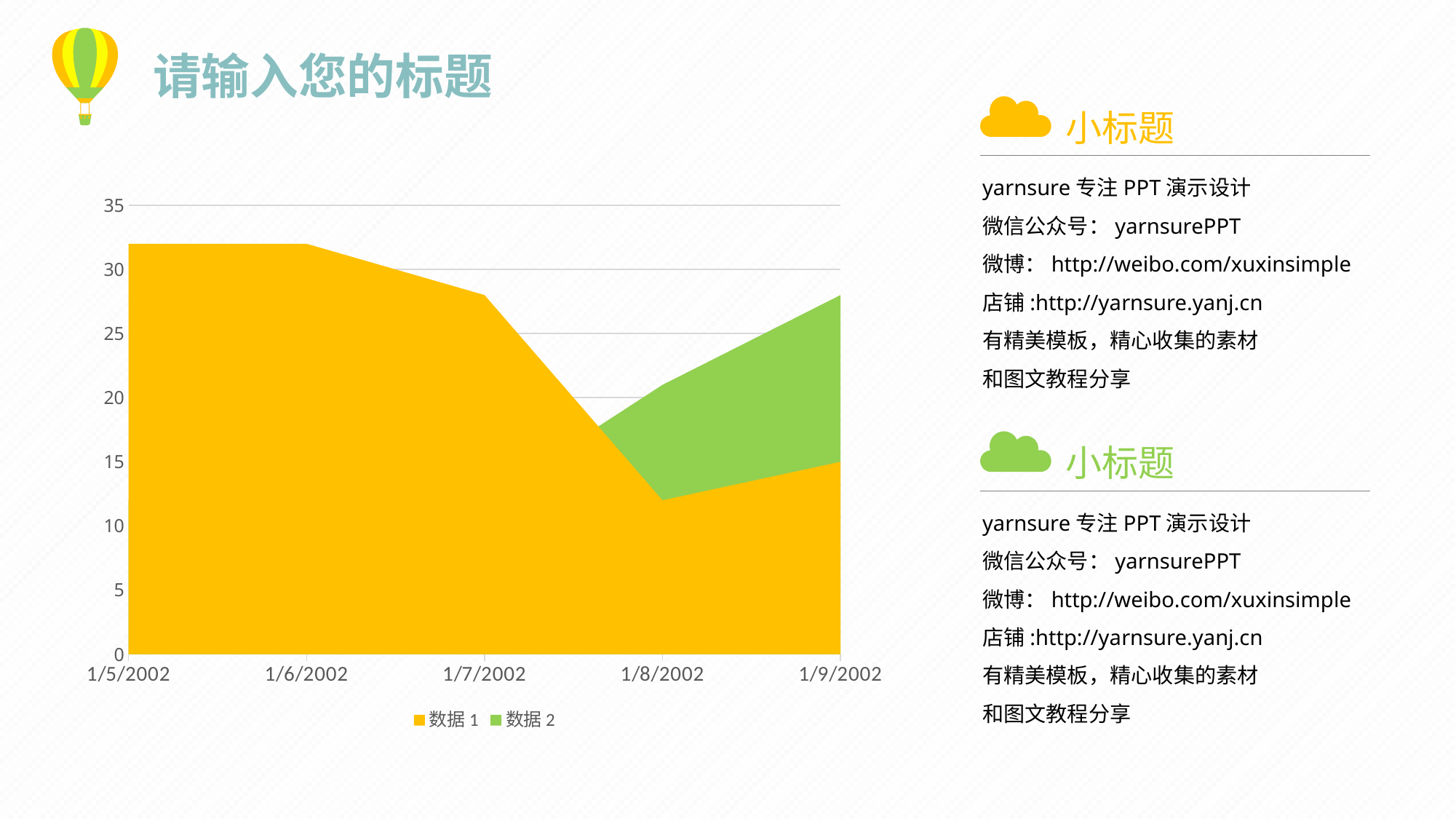
Is the value for 数据 2 on 1/9/2002 greater or less than 25? greater Does the value for 数据 1 rise or fall from 1/6/2002 to 1/8/2002? Fall On which date is the value for 数据 1 lowest? 1/8/2002 How many dates are shown on the x axis of the chart? 5 Is the value for 数据 1 on 1/7/2002 greater or less than 25? greater What kind of chart is shown on the slide? Area chart Is the value for 数据 1 on 1/5/2002 greater or less than 30? greater How many series does the chart legend list? 2 Which is larger for 数据 1: the value on 1/7/2002 or the value on 1/9/2002? 1/7/2002 What colour represents 数据 1 in the chart? Yellow What are the two series named in the chart legend? 数据 1 and 数据 2